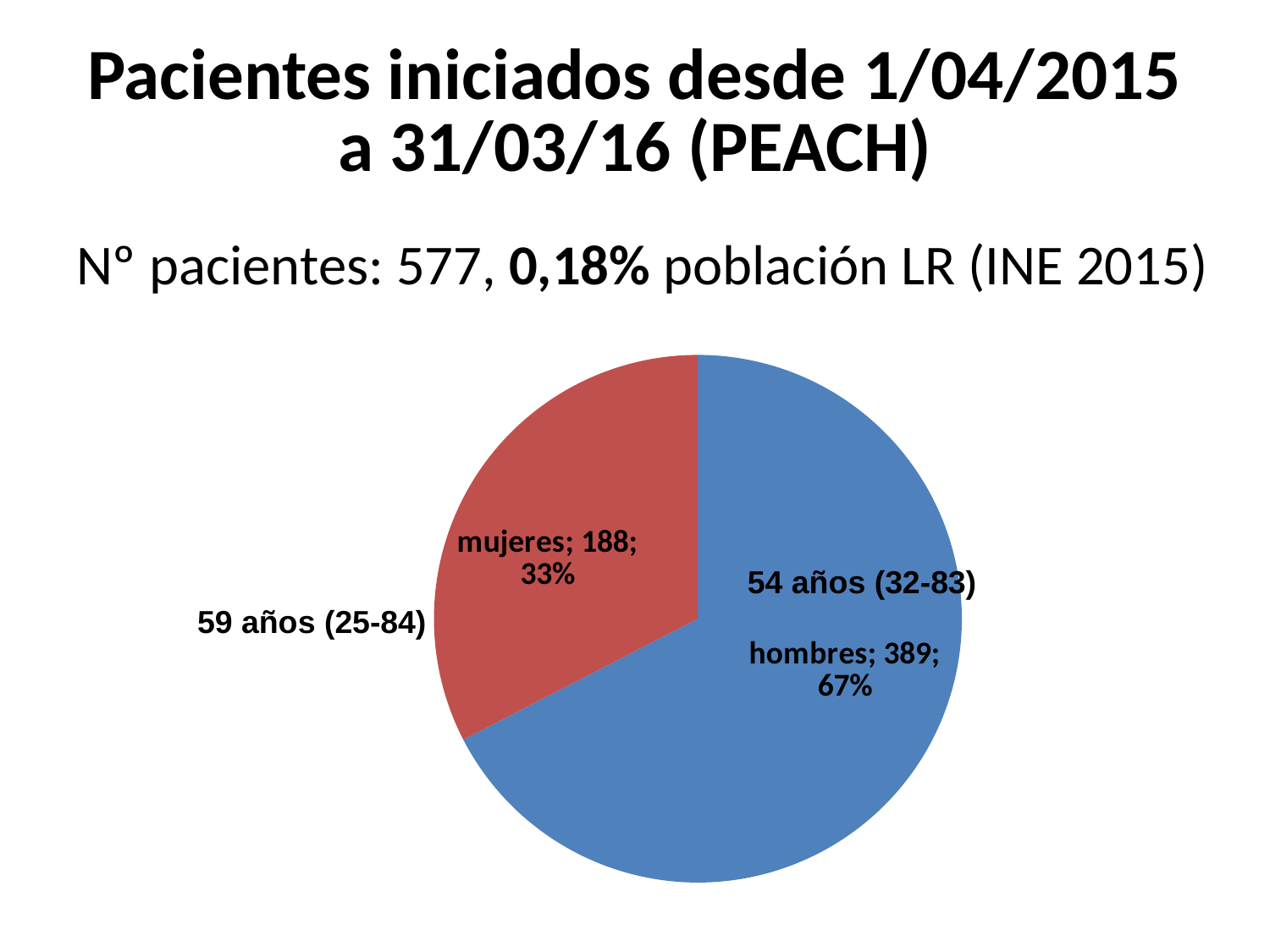
Which slice has more patients, 'hombres' or 'mujeres'? hombres What is the total number of patients across both slices? 577 What share of the pie does the 'mujeres' slice represent? 33% What colour is the 'mujeres' slice? red Which slice is the largest? hombres What kind of chart is shown on the slide? pie chart What share of the pie does the 'hombres' slice represent? 67% How many patients are in the 'hombres' slice? 389 How many patients are in the 'mujeres' slice? 188 Which slice is the smallest? mujeres How many slices does the pie chart have? 2 What is the difference in number of patients between 'hombres' and 'mujeres'? 201